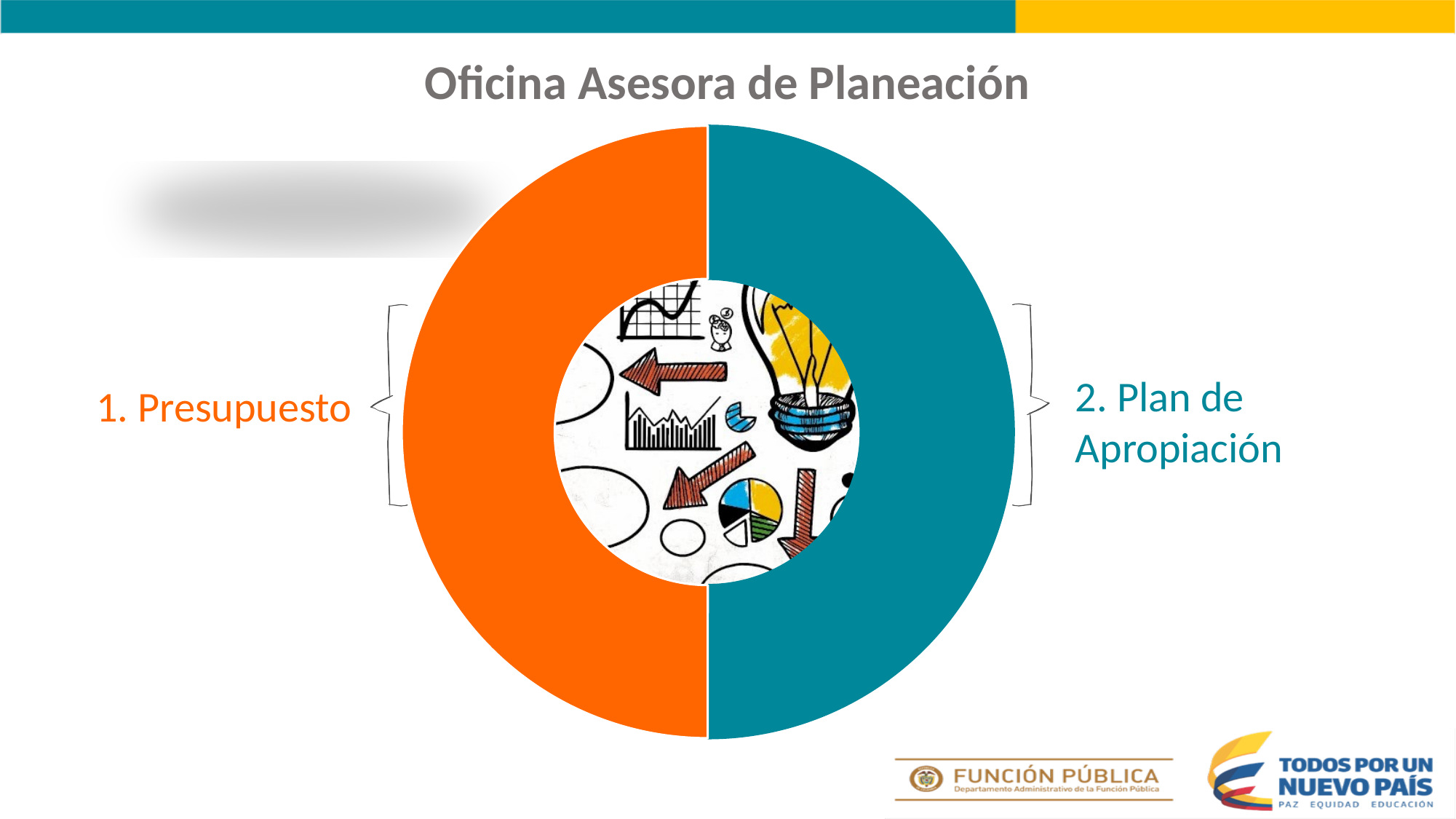
What is the title shown above the donut chart? Oficina Asesora de Planeación Which segment of the donut chart is coloured orange? 1. Presupuesto Which segment of the donut chart is on the left side? 1. Presupuesto Which label is attached to the teal segment of the donut chart? 2. Plan de Apropiación What kind of chart is shown on the slide? Donut chart How many segments does the donut chart have? 2